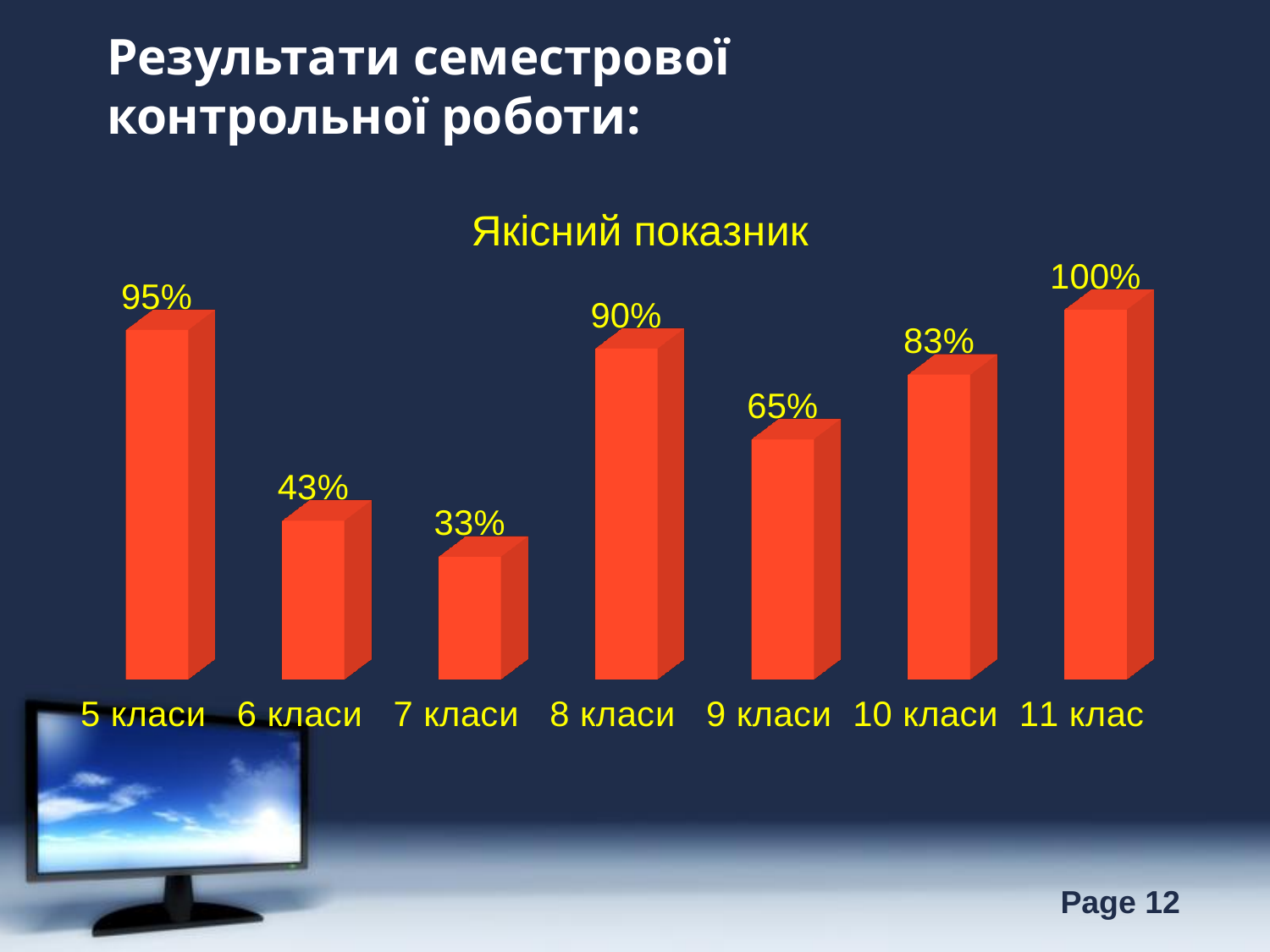
What is the title of the chart? Якісний показник What is the value for 5 класи? 95% Which category has the highest value? 11 клас Which category has the lowest value? 7 класи How many categories are shown in the chart? 7 What is the value for 10 класи? 83% What colour are the bars in the chart? red What is the value for 7 класи? 33% What is the difference between the values for 8 класи and 9 класи? 25% Which is larger, the value for 5 класи or the value for 8 класи? 5 класи What is the difference between the values for 6 класи and 7 класи? 10% What kind of chart is shown on the slide? bar chart